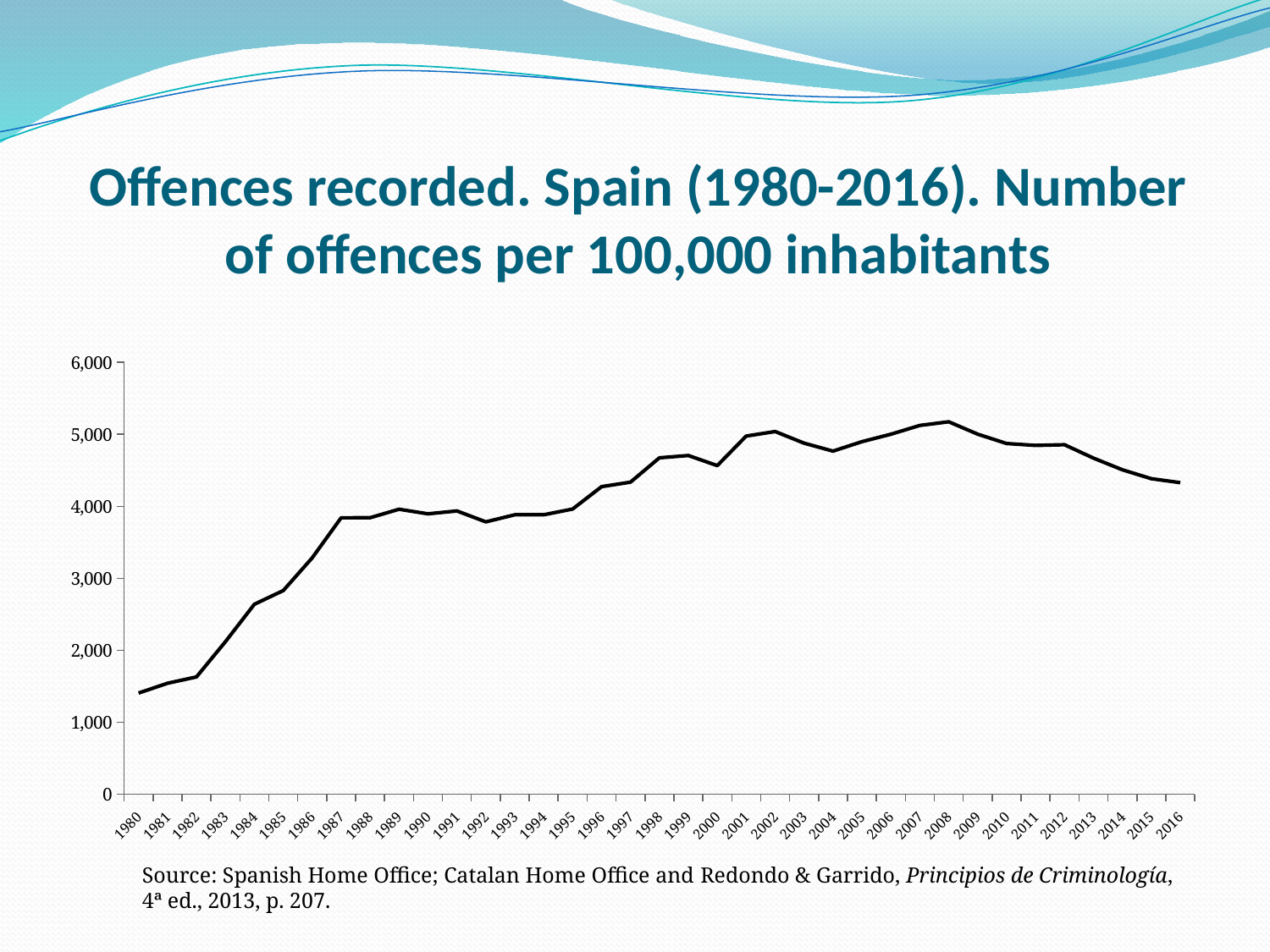
Do the values rise or fall between 1980 and 1987? rise Is the value for 2008 greater or less than 5,000? greater What kind of chart is shown on the slide? Line chart Is the value for 1984 greater or less than 2,000? greater Do the values rise or fall between 2008 and 2016? fall Is the value for 1980 greater or less than 2,000? less What is the title of the chart? Offences recorded. Spain (1980-2016). Number of offences per 100,000 inhabitants Which is larger, the value for 1990 or the value for 2000? 2000 How many years are plotted along the x axis? 37 Which year has the lowest number of offences per 100,000 inhabitants? 1980 Which year has the highest number of offences per 100,000 inhabitants? 2008